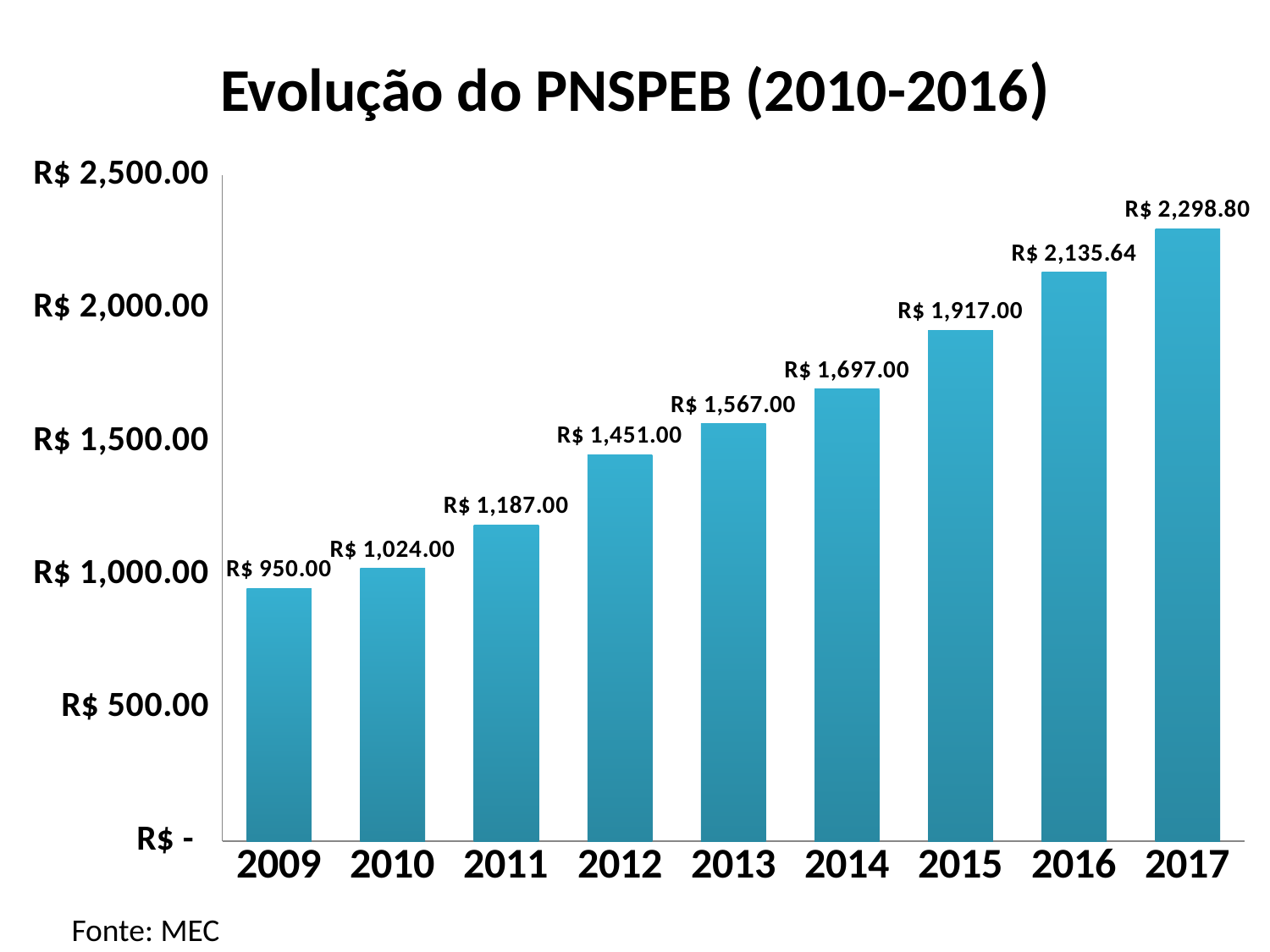
What is the difference between the values for 2012 and 2011? R$ 264.00 Which year has the highest value? 2017 What is the difference between the values for 2017 and 2016? R$ 163.16 Do the values rise or fall from 2009 to 2017? rise What is the value for 2013? R$ 1,567.00 What kind of chart is this? bar chart Is the value for 2012 greater or less than R$ 1,500.00? less What is the value for 2016? R$ 2,135.64 What is the value for 2009? R$ 950.00 How many years are shown on the x axis? 9 Which year has the lowest value? 2009 Which is larger, the value for 2014 or the value for 2015? 2015